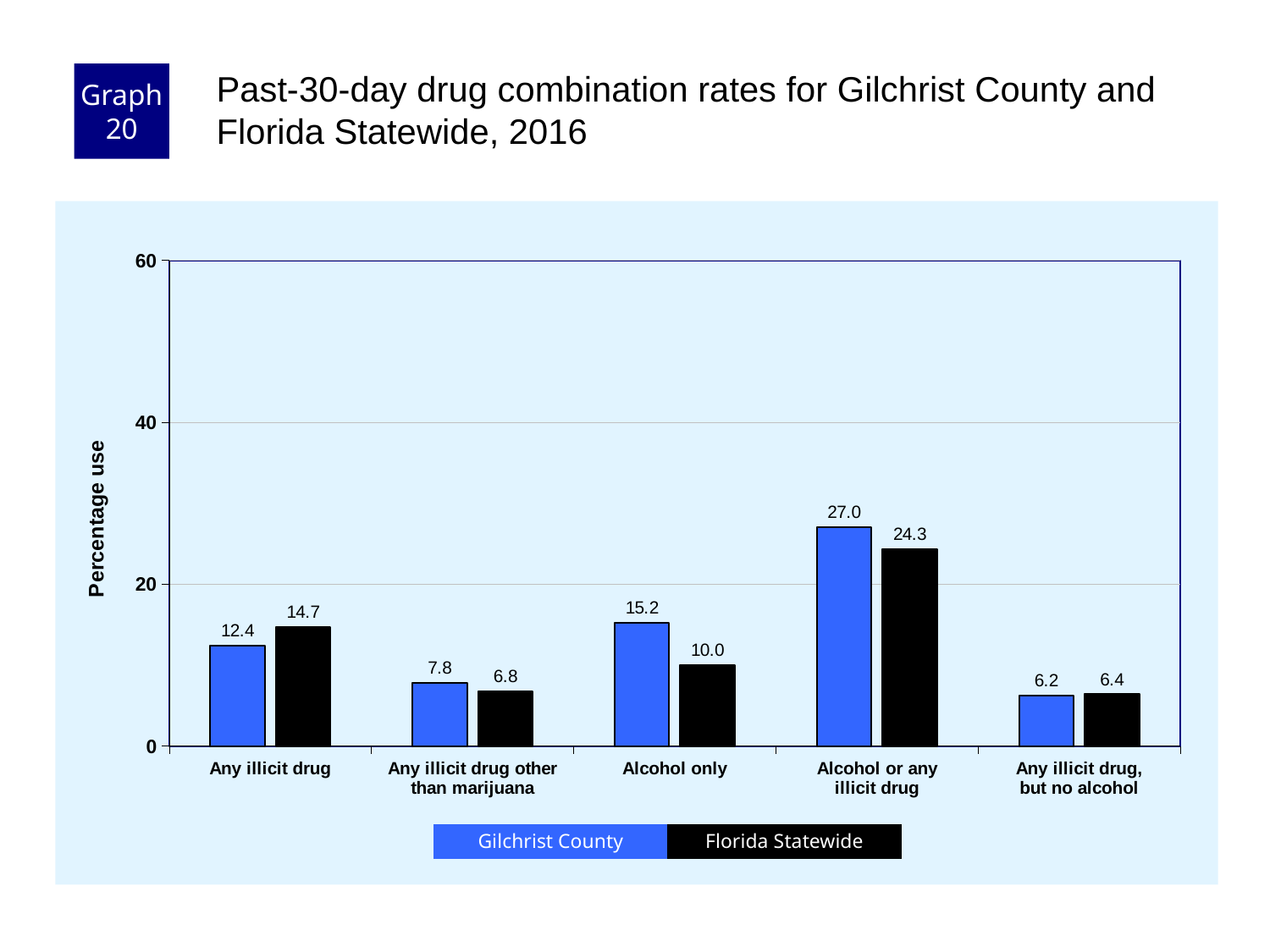
What is the Gilchrist County value for Alcohol only? 15.2 What is the difference between the Gilchrist County and Florida Statewide values for Alcohol or any illicit drug? 2.7 For Any illicit drug other than marijuana, which is larger: Gilchrist County or Florida Statewide? Gilchrist County Is the Florida Statewide value for Alcohol or any illicit drug greater or less than 20? greater Which category has the highest Gilchrist County value? Alcohol or any illicit drug What kind of chart is shown on the slide? bar chart What is the difference between the Gilchrist County and Florida Statewide values for Alcohol only? 5.2 How many series does the legend list? 2 What is the Gilchrist County value for Any illicit drug, but no alcohol? 6.2 How many categories are shown on the x axis? 5 What is the Florida Statewide value for Any illicit drug? 14.7 Which category has the lowest Florida Statewide value? Any illicit drug, but no alcohol